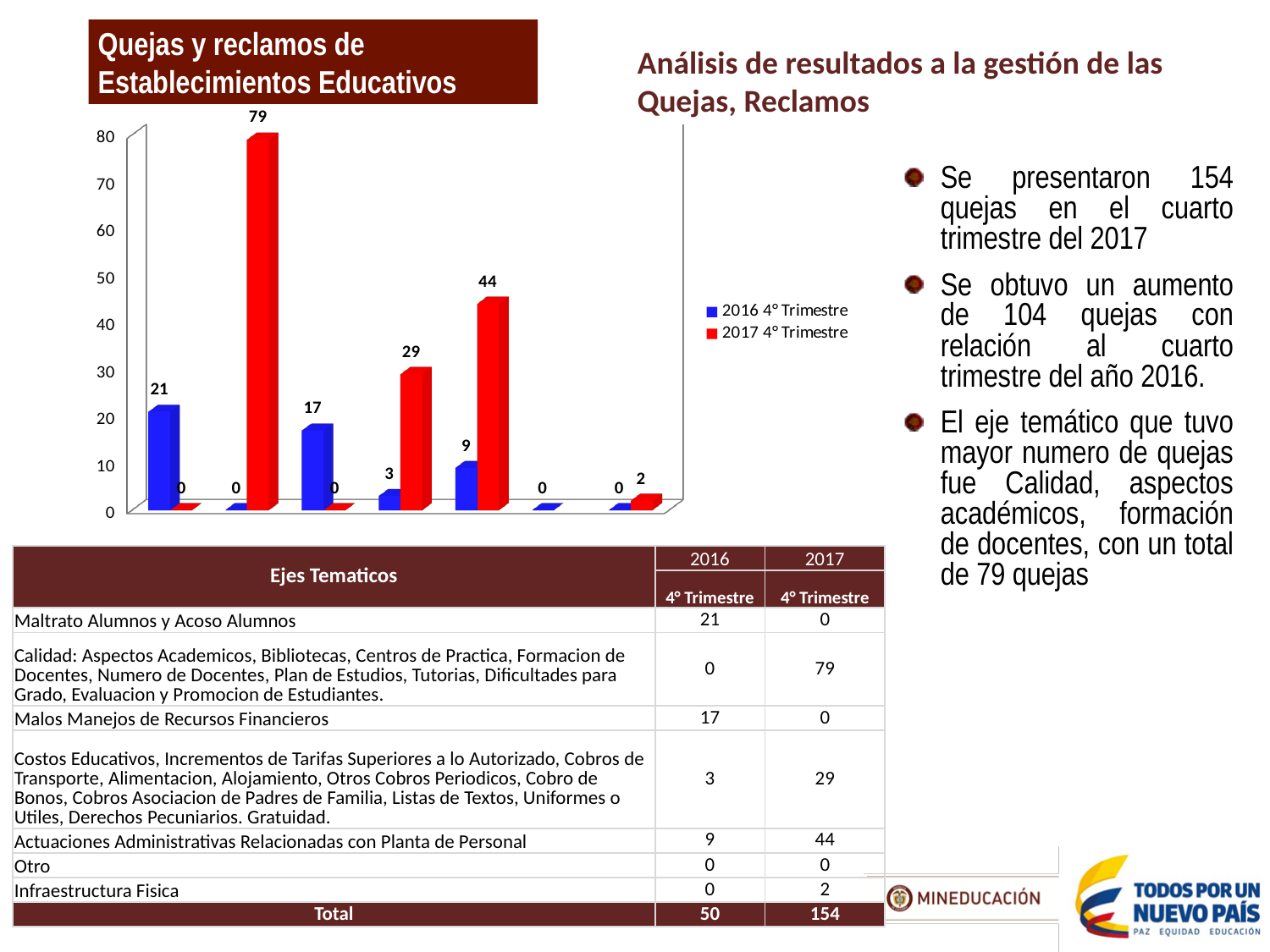
According to the table, what is the total for 2017 4° Trimestre? 154 What is the difference between the 2017 and 2016 values for Actuaciones Administrativas Relacionadas con Planta de Personal? 35 What is the highest value shown for the 2017 4° Trimestre series? 79 How many series does the chart legend list? 2 What is the highest value shown for the 2016 4° Trimestre series? 21 What kind of chart is shown on the slide? bar chart How many categories are plotted in the chart? 7 Which is larger: the 2017 value for Costos Educativos (29) or the 2016 value for Malos Manejos de Recursos Financieros (17)? 29 (Costos Educativos, 2017) What colour represents the 2017 4° Trimestre series in the chart? red What is the 2017 4° Trimestre value for Actuaciones Administrativas Relacionadas con Planta de Personal? 44 Is the highest 2017 4° Trimestre bar greater or less than 70? greater What is the 2016 4° Trimestre value for Malos Manejos de Recursos Financieros? 17